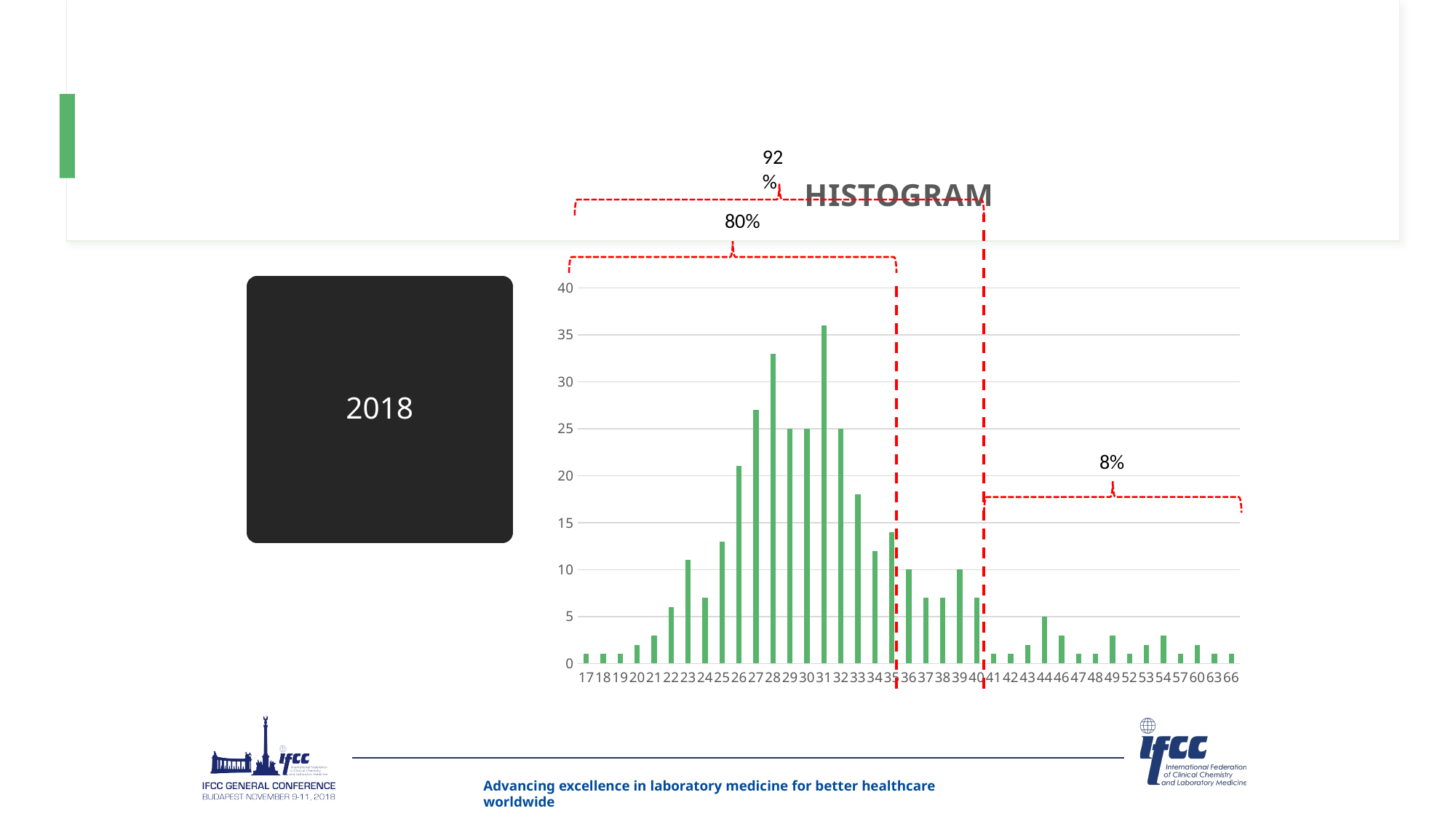
Which has a higher value, category 27 or category 28? 28 Do the values rise or fall along the x axis from category 17 to category 31? rise Is the value for category 44 greater or less than 10? less Is the value for category 31 greater or less than 35? greater What kind of chart is shown on the slide? bar chart What percentage is annotated above the right-hand region of the chart (categories 41 onward)? 8% Is the value for category 28 greater or less than 30? greater What is the title of the chart? HISTOGRAM Which category has the highest bar? 31 Which has a higher value, category 23 or category 44? 23 How many categories are shown on the x axis? 39